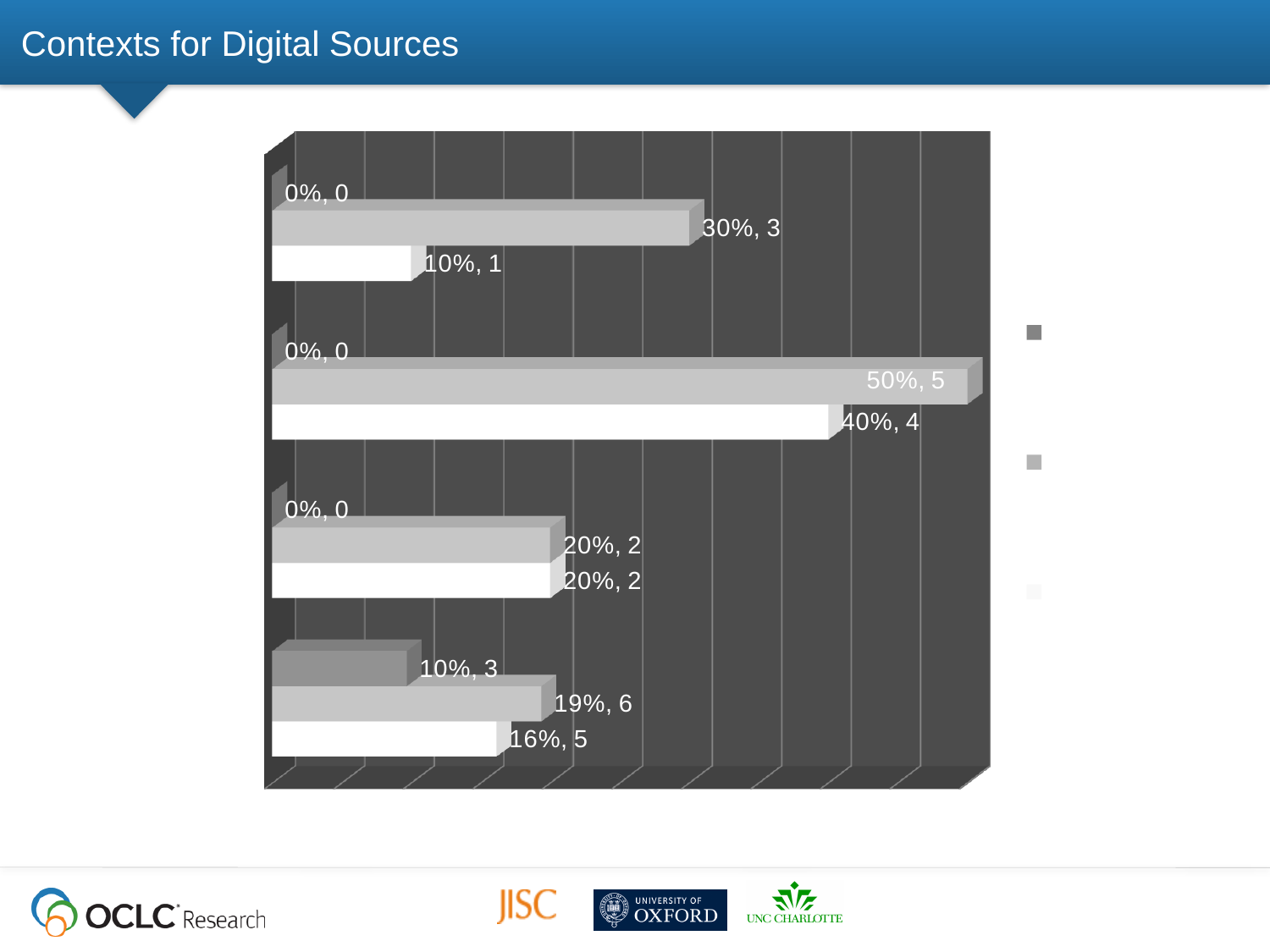
In the third group from the top, what is the difference between the light gray bar's percentage and the white bar's percentage? 0% In the bottom group, what is the difference in percentage between the light gray bar (19%) and the white bar (16%)? 3% What is the data label on the dark gray bar in the bottom group? 10%, 3 What is the data label on the white bar in the bottom group? 16%, 5 What is the data label on the white bar in the second group from the top? 40%, 4 What is the data label on the light gray bar in the top group? 30%, 3 How many series does the legend list? 3 What kind of chart is shown on the slide? bar chart How many groups of bars (categories) does the chart show? 4 What is the data label on the longest bar in the chart? 50%, 5 How many of the dark gray bars have a data label of "0%, 0"? 3 In the top group, which is larger: the light gray bar or the white bar? the light gray bar